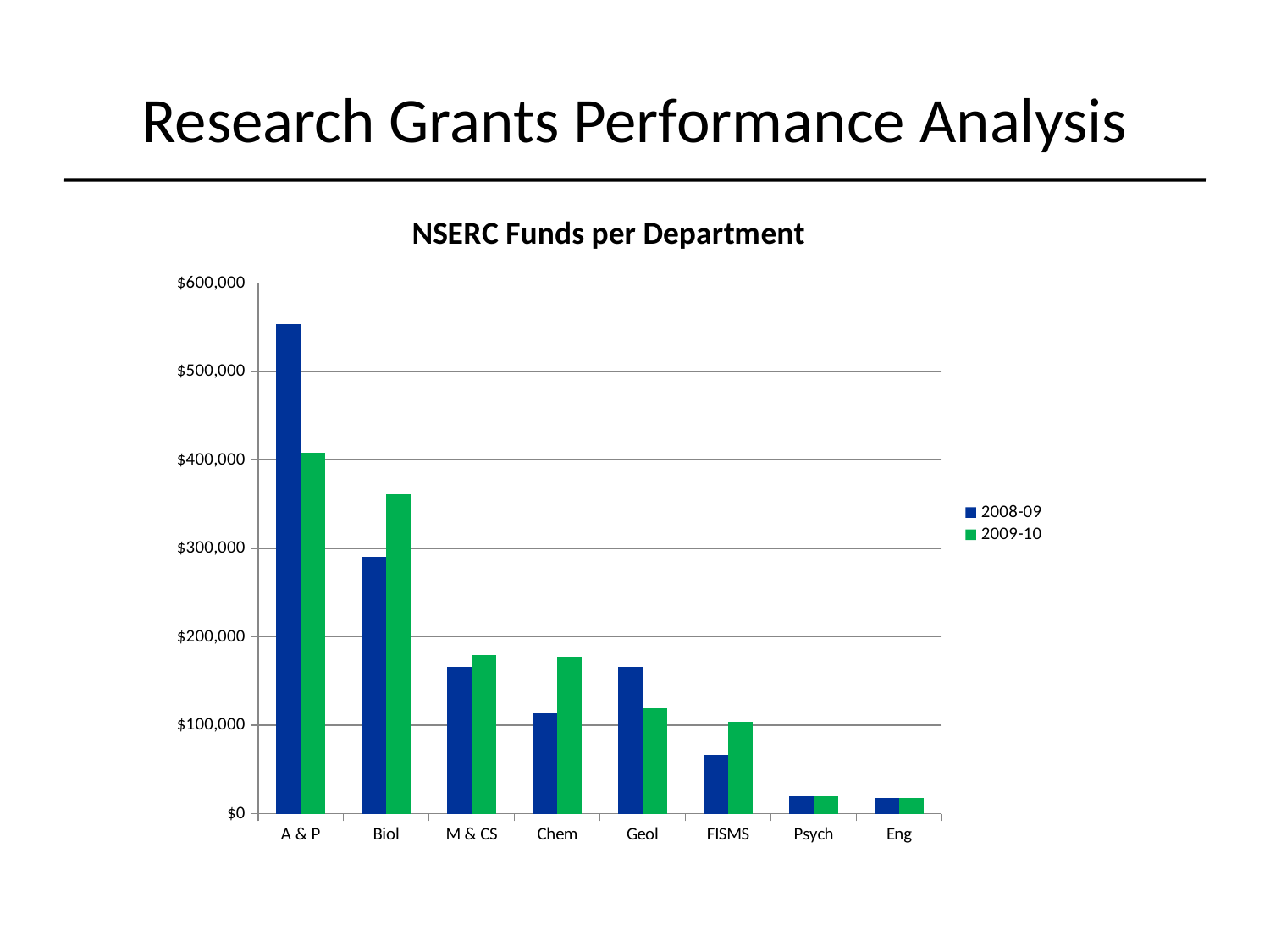
Is the 2008-09 value for A & P greater or less than $500,000? greater Which department has the highest 2009-10 value? A & P Which department has the highest 2008-09 value? A & P How many series does the legend list? 2 How many departments are shown on the x axis? 8 For Biol, which series has the larger value, 2008-09 or 2009-10? 2009-10 Is the 2009-10 value for Biol greater or less than $300,000? greater What kind of chart is shown on the slide? bar chart For Geol, which series has the larger value, 2008-09 or 2009-10? 2008-09 Is the 2008-09 value for FISMS greater or less than $100,000? less Which series is shown in green in the legend? 2009-10 What is the title of the chart? NSERC Funds per Department